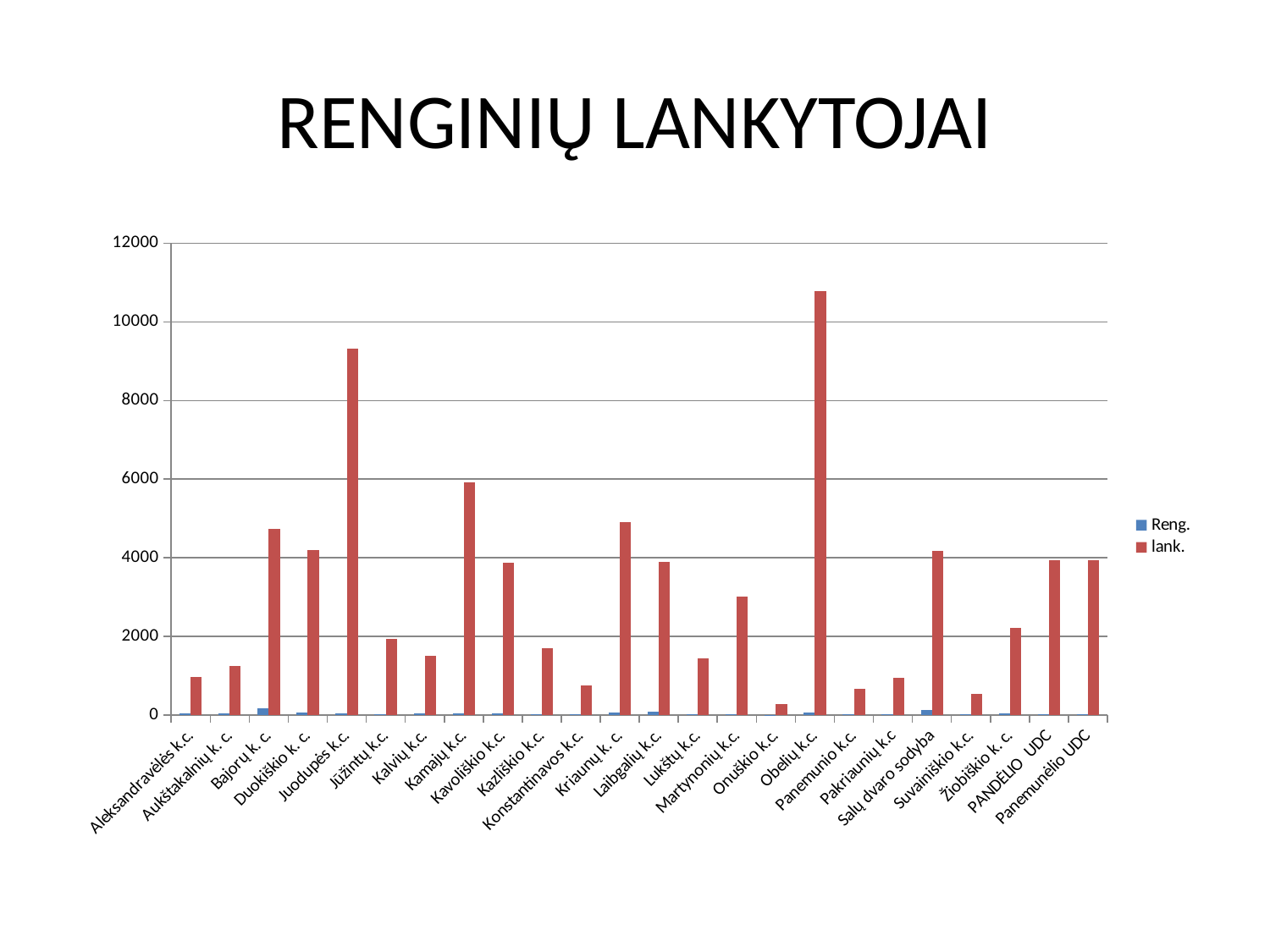
Which has a larger lank. value, Juodupės k. c. or Kamajų k.c.? Juodupės k. c. Is the lank. value for Martynonių k.c. greater or less than 2000? greater Is the lank. value for Aleksandravėlės k.c. greater or less than 2000? less Is the lank. value for Juodupės k. c. greater or less than 8000? greater Which category has the highest value for lank.? Obelių k.c. How many series does the legend list? 2 How many categories are shown on the x axis? 24 What is the title of the chart? RENGINIŲ LANKYTOJAI Which category has the lowest value for lank.? Onuškio k.c. What kind of chart is shown on the slide? bar chart